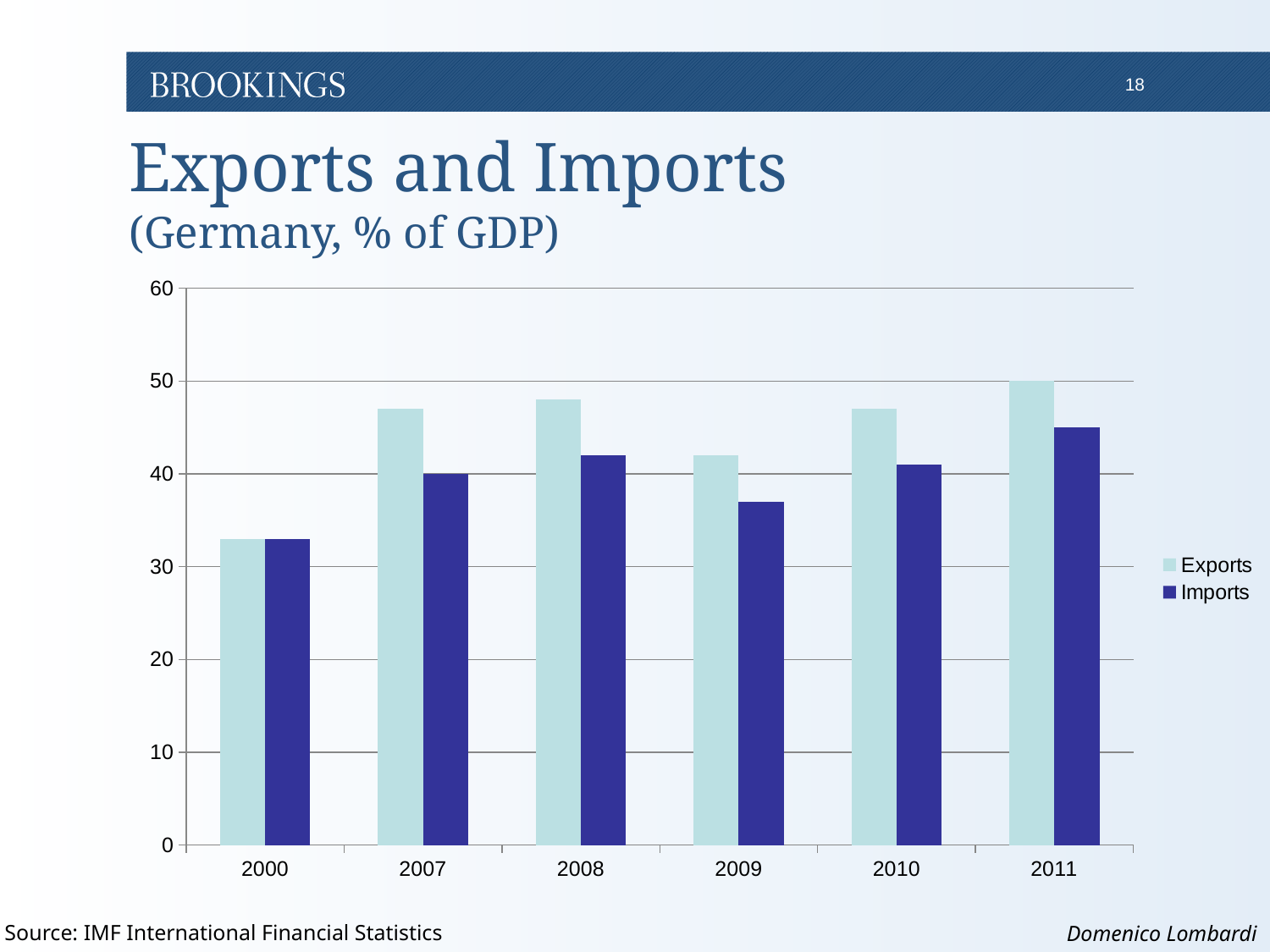
What is the Imports value for 2007? 40 Is the Imports value for 2009 greater or less than 40? less Do the Imports values rise or fall from 2009 to 2011? rise Is the Exports value for 2007 greater or less than 50? less How many series does the legend list? 2 Which year has the lowest Exports value? 2000 How many years are shown on the x axis? 6 What kind of chart is shown on the slide? bar chart Which year has the lowest Imports value? 2000 What is the Exports value for 2011? 50 In 2009, which is larger, Exports or Imports? Exports Which year has the highest Imports value? 2011